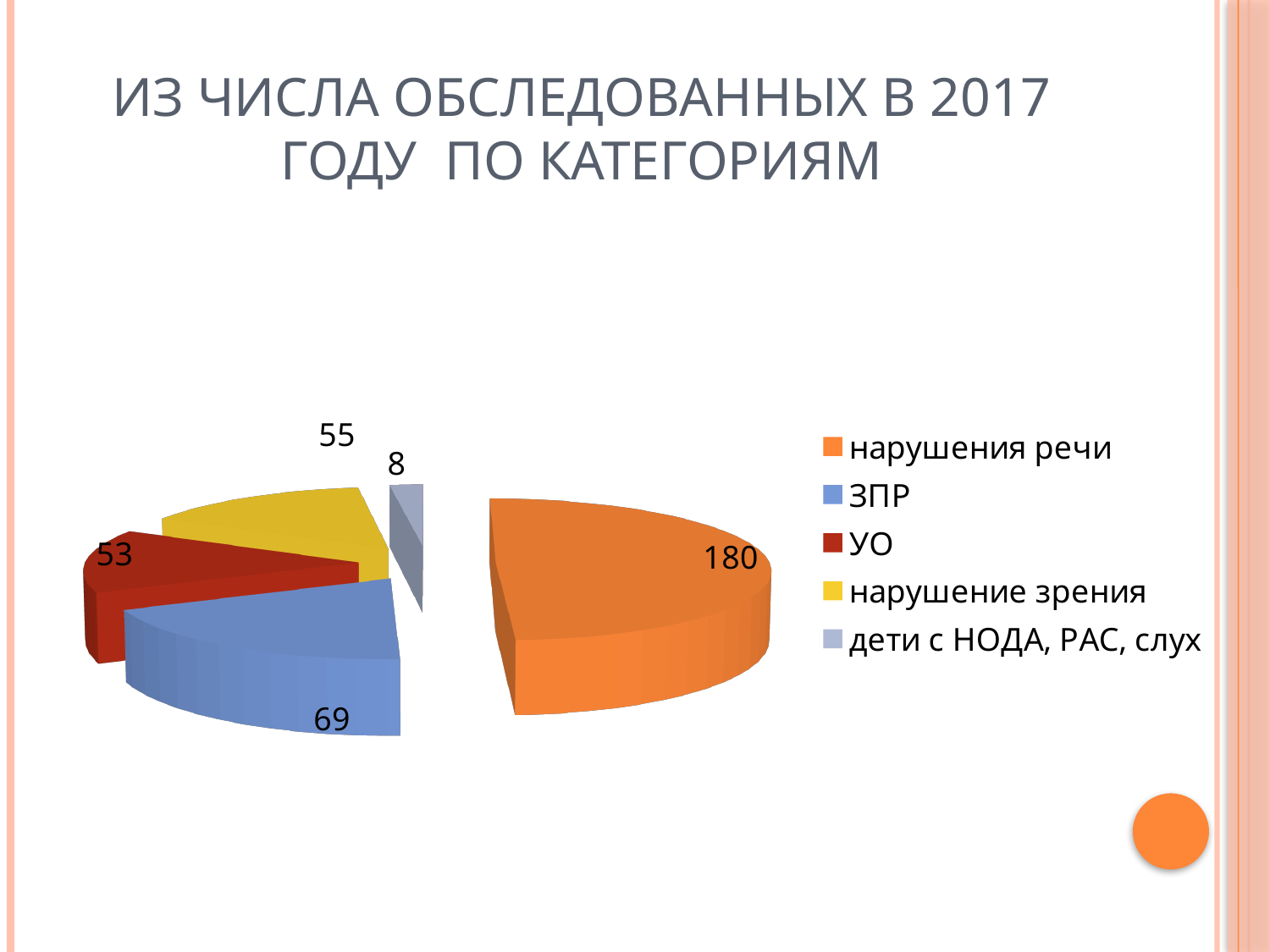
What colour is the slice for ЗПР? blue What type of chart is shown on the slide? pie chart Which category has the smallest slice? дети с НОДА, РАС, слух What is the value for дети с НОДА, РАС, слух? 8 How many categories does the pie chart show? 5 What is the value for УО? 53 Which category has the largest slice? нарушения речи What is the value for нарушения речи? 180 Which is larger, the value for нарушение зрения or the value for УО? нарушение зрения What is the value for ЗПР? 69 What is the difference between the values for нарушения речи and ЗПР? 111 What is the value for нарушение зрения? 55